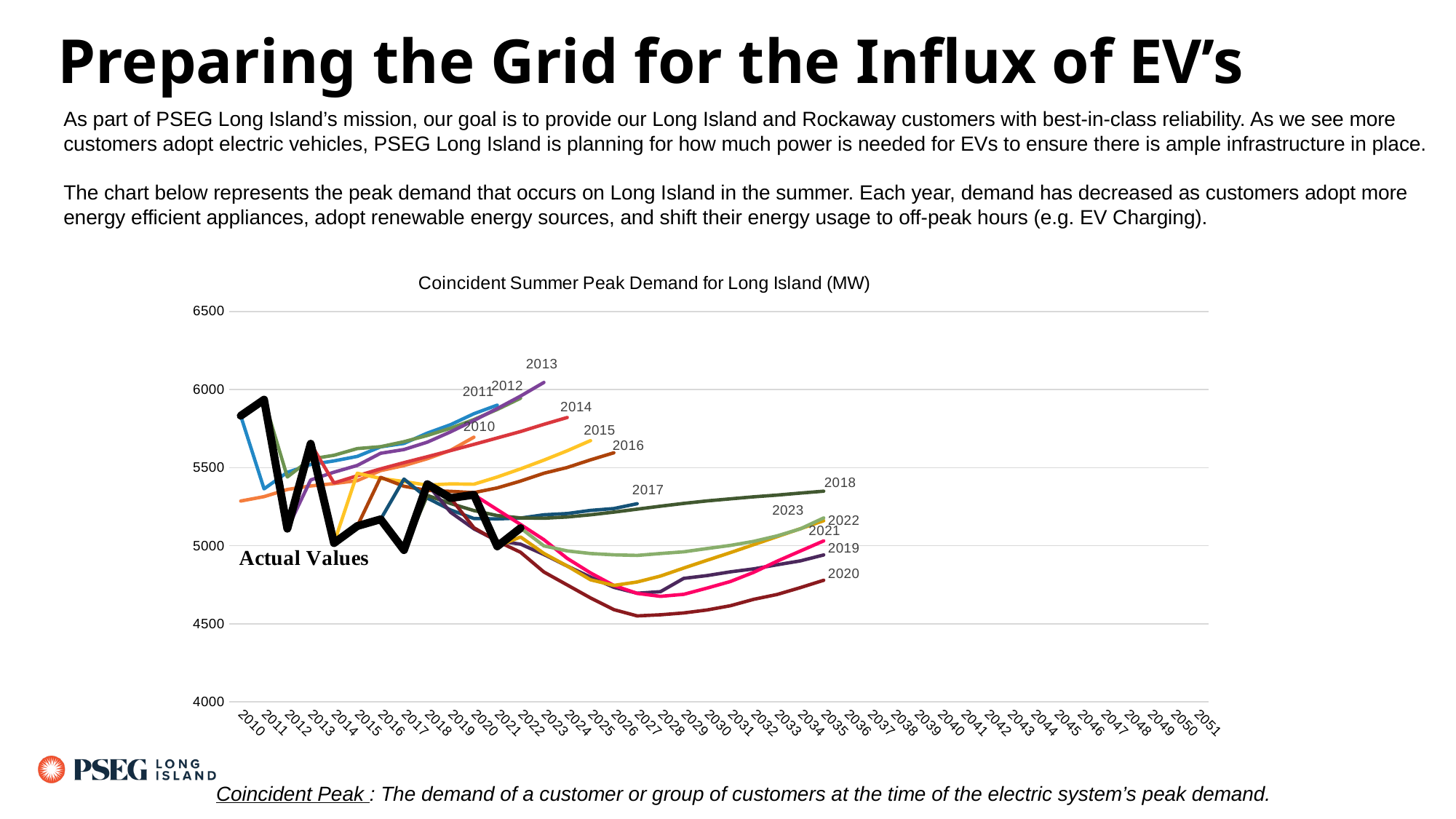
Which forecast line reaches the highest value on the chart? 2013 Is the lowest point of the 2020 forecast line greater or less than 4500? greater What kind of chart is shown on the slide? Line chart Is the final value of the 2016 forecast line greater or less than 5500? greater What label is given to the thick black line in the chart? Actual Values What is the title of the chart? Coincident Summer Peak Demand for Long Island (MW) Does the 2013 forecast line rise or fall along the x axis? rise Is the final value of the 2013 forecast line greater or less than 6000? greater Which ends at a higher value, the 2013 forecast line or the 2020 forecast line? 2013 Which forecast line dips to the lowest value on the chart? 2020